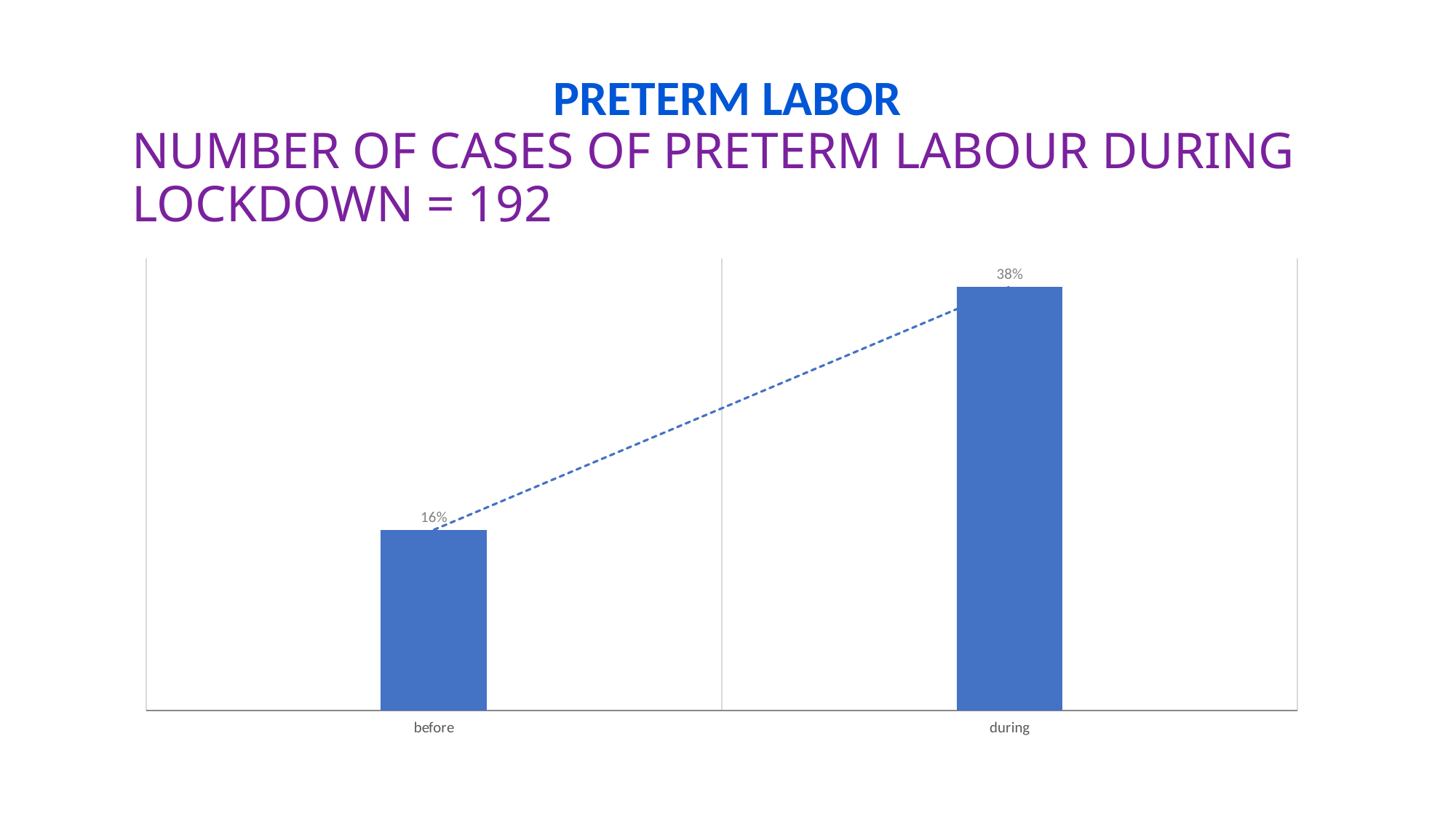
What colour are the bars in the chart? blue What is the difference between the values for "during" and "before"? 22% Which category has the lowest value? before Which is larger, the value for "before" or the value for "during"? during What is the value for "during"? 38% What is the number of cases of preterm labour during lockdown stated in the slide heading? 192 Which category has the highest value? during What is the value for "before"? 16% Do the values rise or fall from "before" to "during"? rise What kind of chart is shown on the slide? bar chart How many categories are shown on the x axis? 2